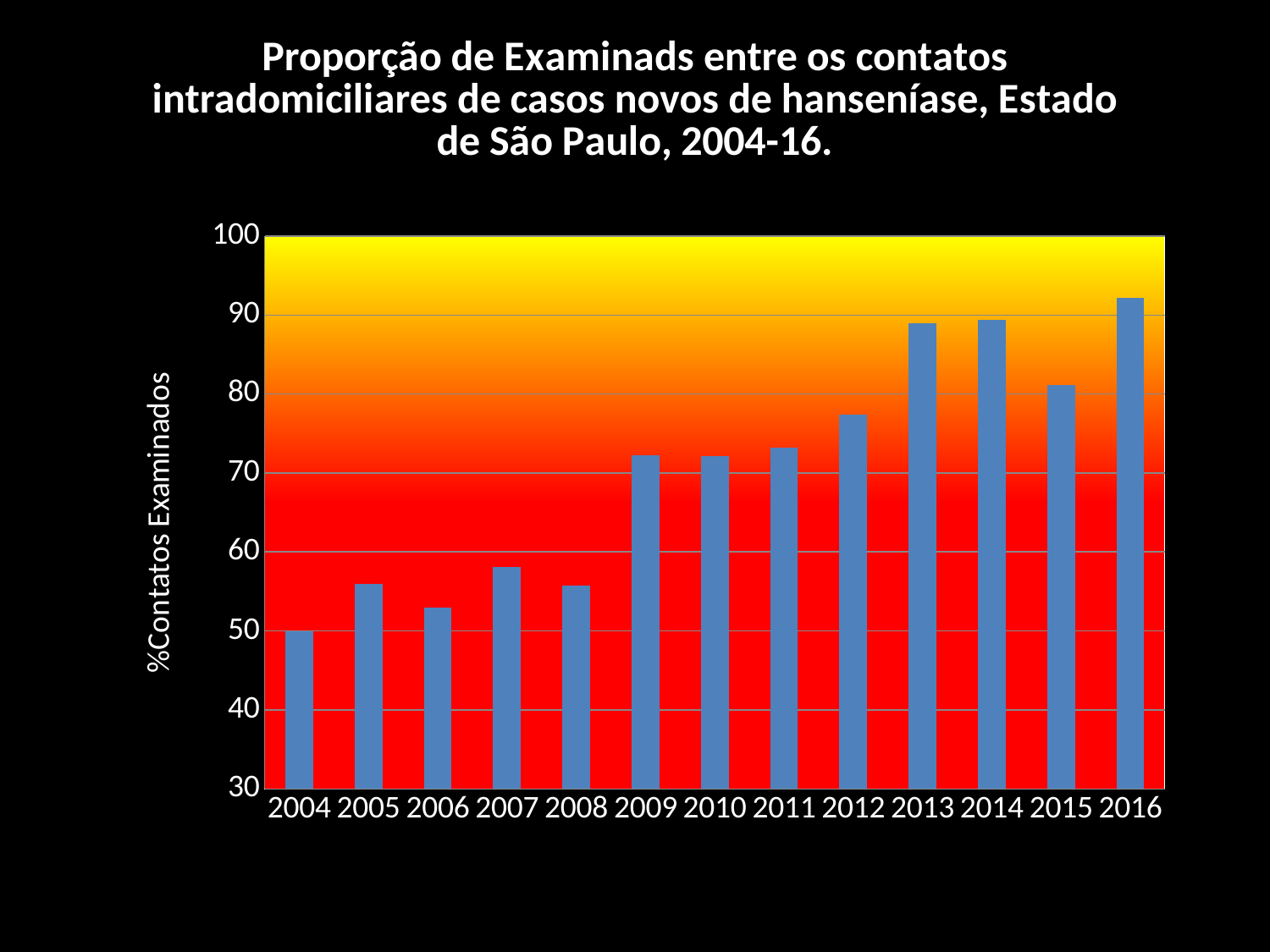
Overall, do the values rise or fall from 2004 to 2016? rise Which year has the highest proportion of examined contacts? 2016 Which is larger, the value for 2013 or the value for 2008? 2013 Is the value for 2009 greater or less than 70? greater Is the value for 2012 greater or less than 80? less What is the label of the y axis? %Contatos Examinados What kind of chart is shown on the slide? bar chart How many years are shown on the x axis of the chart? 13 Which year has the lowest proportion of examined contacts? 2004 Which is larger, the value for 2015 or the value for 2014? 2014 Is the value for 2016 greater or less than 90? greater